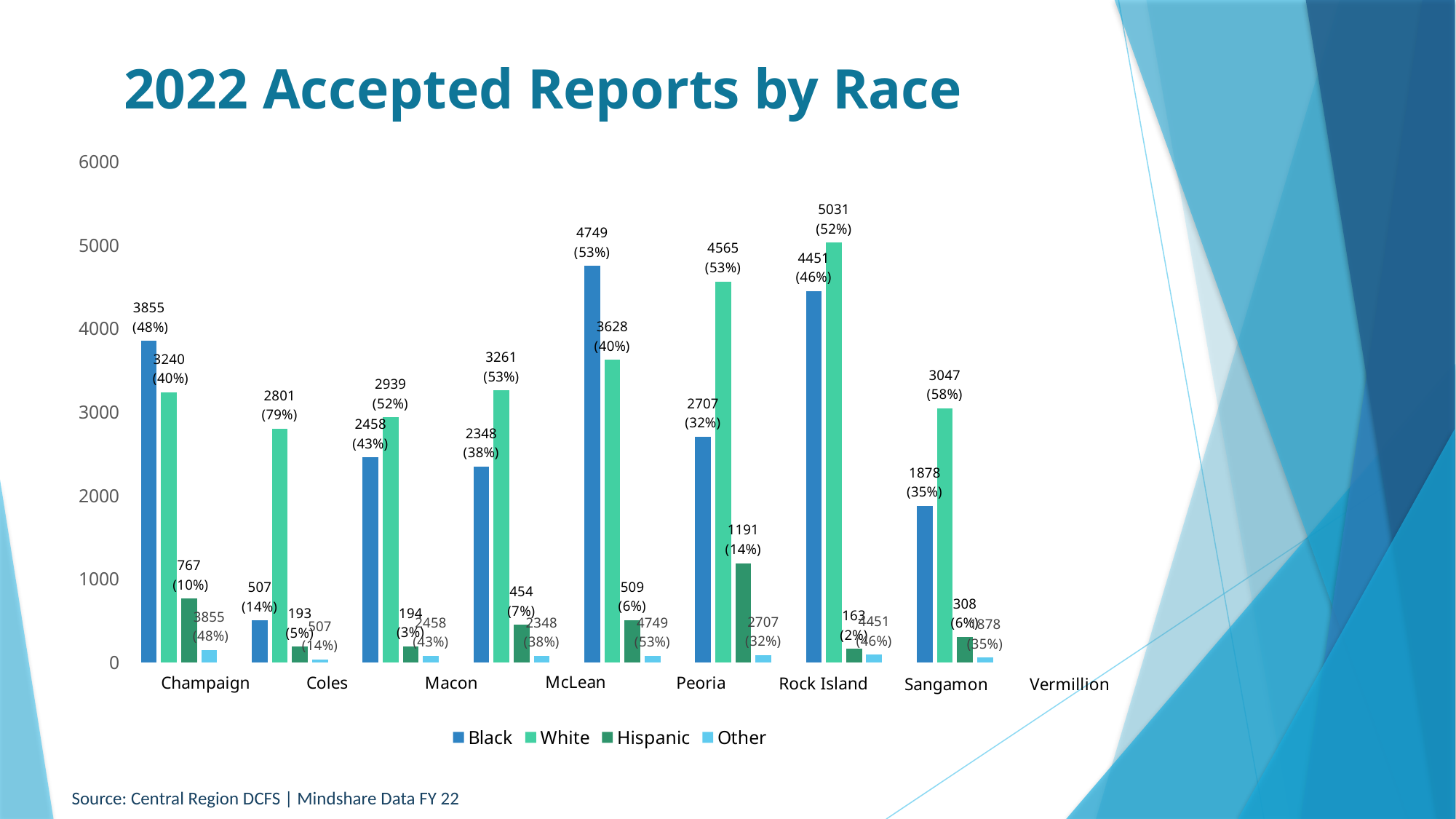
How many series does the legend list? 4 Which county has the highest value for Black? McLean In Peoria, which is larger, the Black value or the White value? White What kind of chart is shown on the slide? Bar chart Which county has the lowest value for Hispanic? Rock Island What is the value for White in Coles? 2801 What percentage is shown for White in Coles? 79% How many counties are shown on the x axis? 8 Is the value for Other in Champaign greater or less than 1000? less What is the difference between the White and Black values in Sangamon? 1169 Which county has the highest value for White? Rock Island What is the value for Hispanic in Rock Island? 163